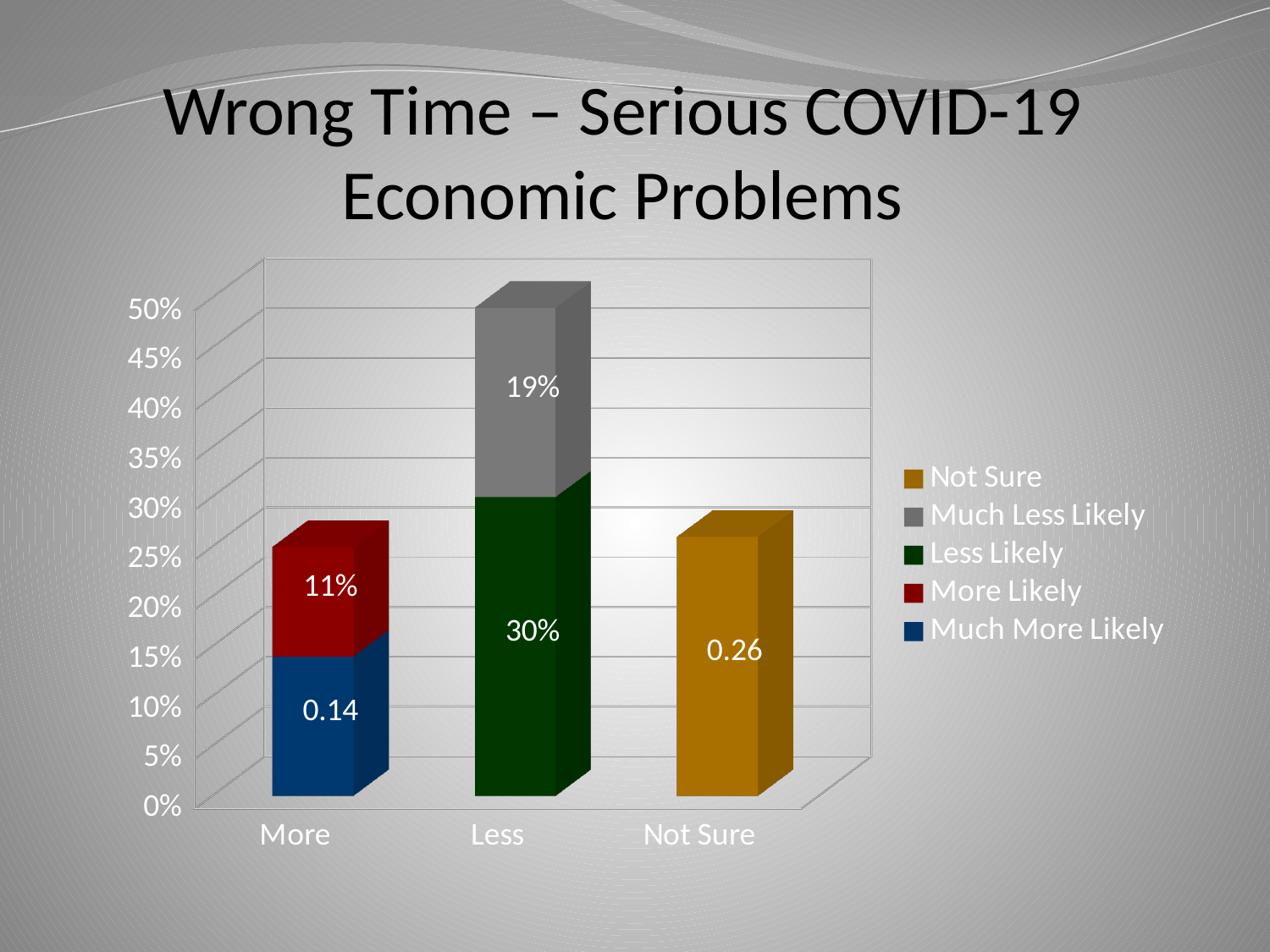
What is the value of the More Likely segment in the More bar? 11% What is the total of the stacked Less bar? 49% Which is larger in the Less bar: the Less Likely segment or the Much Less Likely segment? Less Likely What is the difference between the Less Likely segment and the Much Less Likely segment in the Less bar? 11% What is the value of the Much Less Likely segment in the Less bar? 19% Which category has the shortest stacked bar? More Which category has the tallest stacked bar? Less How many series does the legend list? 5 What is the value of the Less Likely segment in the Less bar? 30% How many categories are shown on the x axis? 3 What is the value labelled on the Not Sure bar? 0.26 What is the value labelled on the Much More Likely segment in the More bar? 0.14